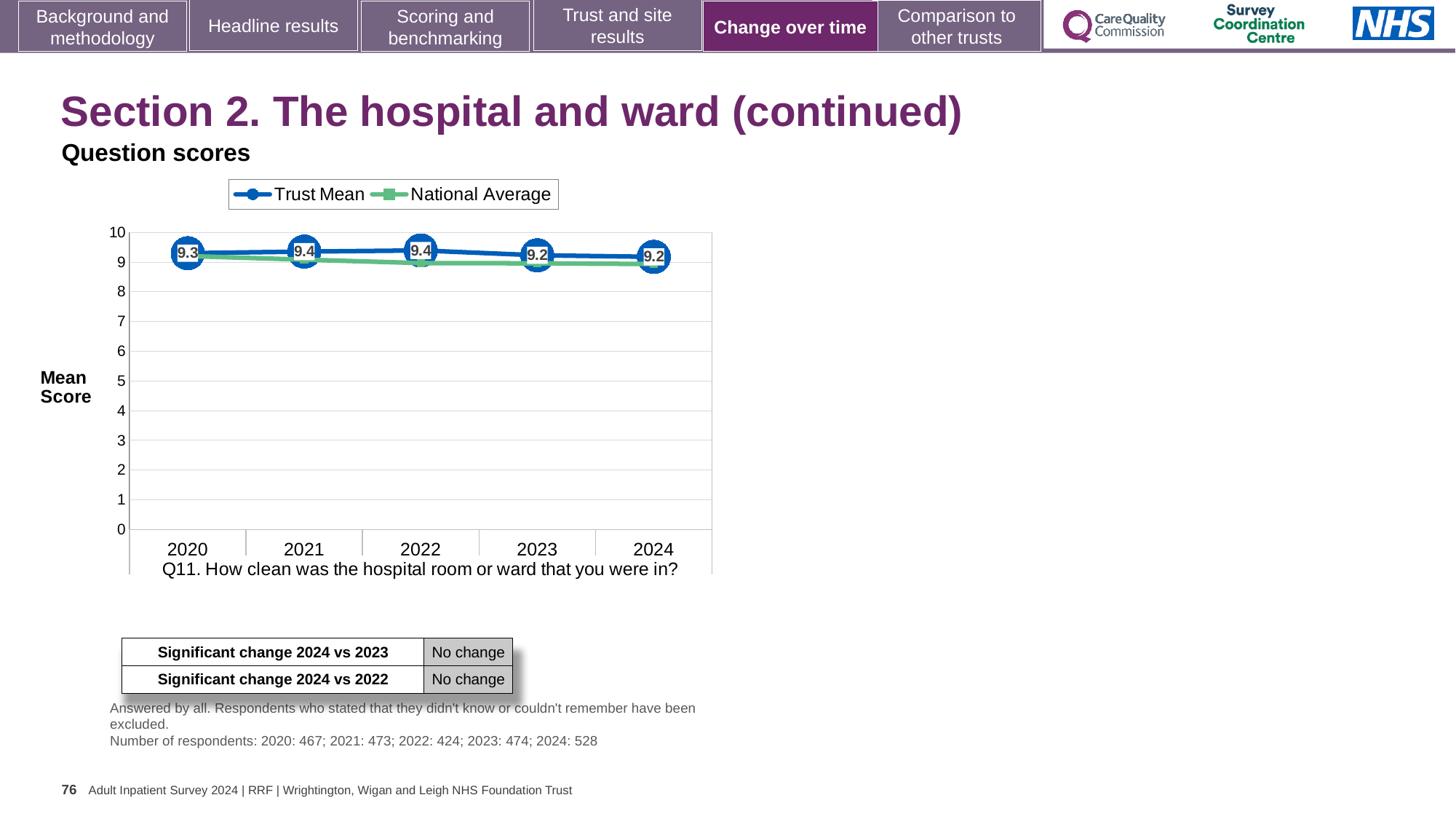
Which survey question does the chart show scores for? Q11. How clean was the hospital room or ward that you were in? Which is larger, the Trust Mean for 2021 or the Trust Mean for 2023? 2021 What is the Trust Mean value for 2020? 9.3 What is the Trust Mean value for 2024? 9.2 Is the National Average value for 2024 greater or less than 8? greater What is the Trust Mean value for 2023? 9.2 What is the difference between the Trust Mean values for 2022 and 2024? 0.2 What kind of chart is shown on the slide? line chart What is the Trust Mean value for 2021? 9.4 How many series does the chart legend list? 2 How many years are shown on the x axis of the chart? 5 Does the Trust Mean rise or fall from 2022 to 2024? fall